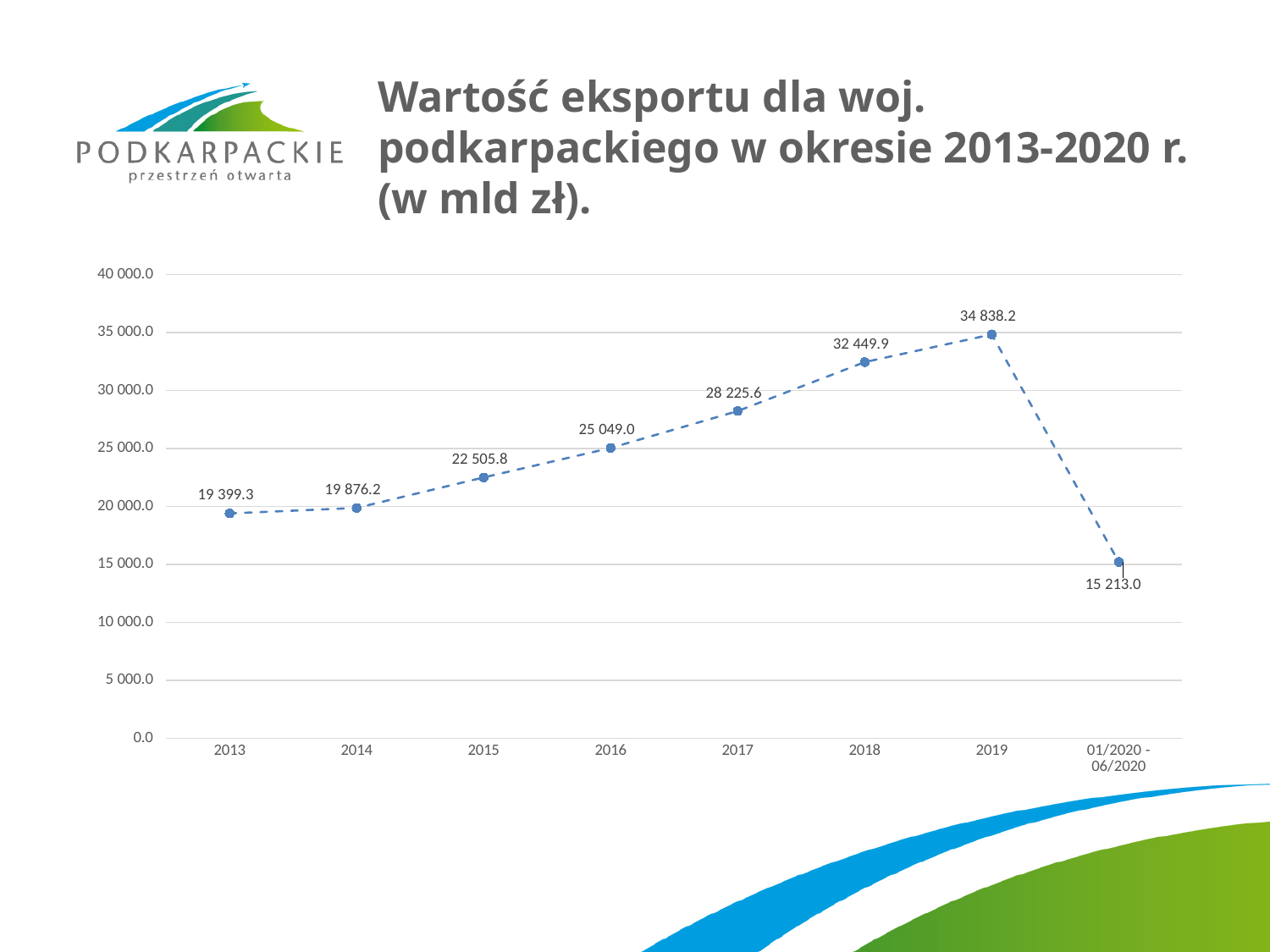
Which period has the lowest export value? 01/2020 - 06/2020 What type of chart is shown on the slide? Line chart What is the export value for 2016? 25 049.0 What is the title of the chart on the slide? Wartość eksportu dla woj. podkarpackiego w okresie 2013-2020 r. (w mld zł). How many data points are plotted on the chart? 8 What is the difference between the export values for 2019 and 2018? 2 388.3 Do the export values rise or fall from 2013 to 2019? Rise What is the difference between the export values for 2014 and 2013? 476.9 Which is larger, the export value for 2017 or for 2015? 2017 What is the value shown for the period 01/2020 - 06/2020? 15 213.0 What is the export value for 2018? 32 449.9 Which period has the highest export value? 2019